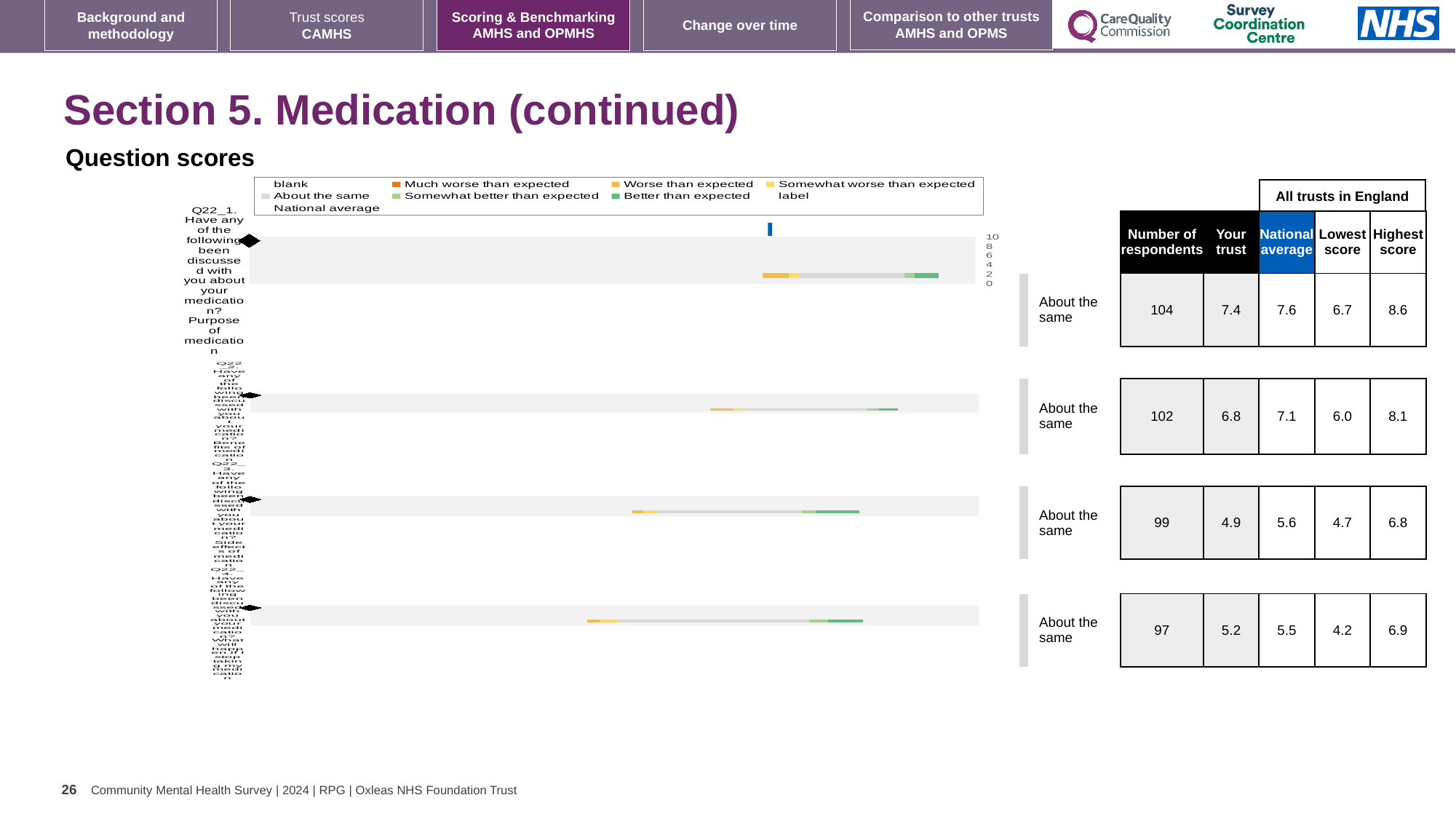
In the table beside the chart, what is the 'Your trust' score for the first row (Q22_1, purpose of medication)? 7.4 In the table beside the chart, what is the national average for the third row? 5.6 In the table beside the chart, what is the difference between the national average and the 'Your trust' score for the first row? 0.2 In the table beside the chart, for the second row, which is larger: the 'Your trust' score or the national average? national average In the table beside the chart, what is the highest score for the fourth row? 6.9 How many bars (questions) are plotted in the 'Question scores' chart? 4 In the table beside the chart, which row has the highest 'Your trust' score? the first row (7.4) What benchmark label is shown next to each of the four bars in the chart? About the same What is the heading above the chart? Question scores What kind of chart is shown under 'Question scores'? bar chart In the chart legend, what colour represents 'Much worse than expected'? orange In the table beside the chart, what is the number of respondents for the first row (Q22_1, purpose of medication)? 104